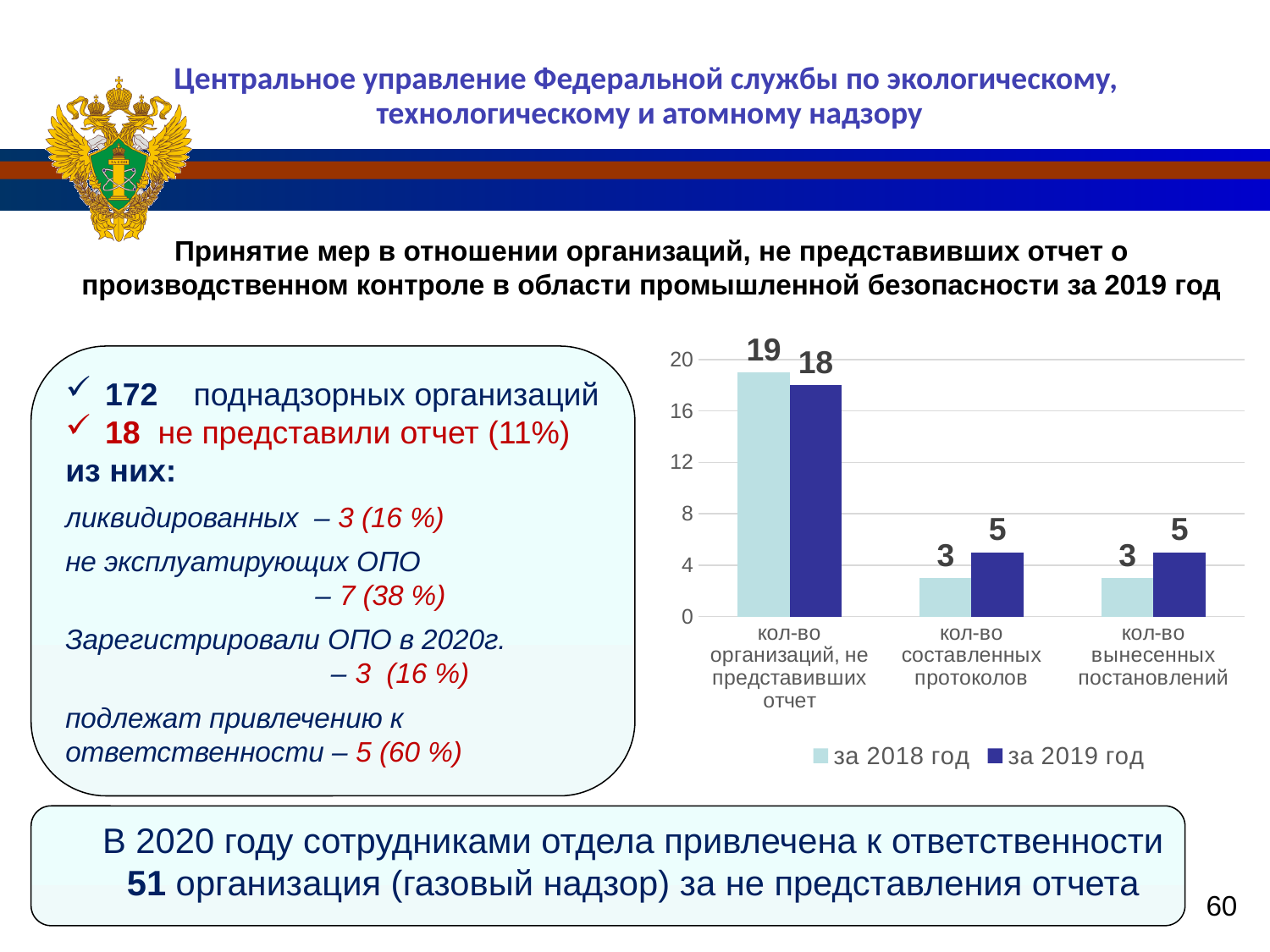
На сколько значение за 2019 год больше значения за 2018 год в категории «кол-во составленных протоколов»? 2 Какого типа эта диаграмма? столбчатая (bar chart) В какой категории значение за 2019 год наибольшее? кол-во организаций, не представивших отчет Какие ряды данных перечислены в легенде диаграммы? за 2018 год, за 2019 год Какое значение показано для категории «кол-во составленных протоколов» за 2019 год? 5 Что больше в категории «кол-во вынесенных постановлений»: значение за 2018 год или за 2019 год? за 2019 год Какое значение показано для категории «кол-во вынесенных постановлений» за 2018 год? 3 Какое значение показано для категории «кол-во организаций, не представивших отчет» за 2019 год? 18 На сколько значение за 2018 год больше значения за 2019 год в категории «кол-во организаций, не представивших отчет»? 1 Сколько категорий показано на оси x диаграммы? 3 Какое значение показано для категории «кол-во организаций, не представивших отчет» за 2018 год? 19 Сколько рядов данных перечислено в легенде диаграммы? 2